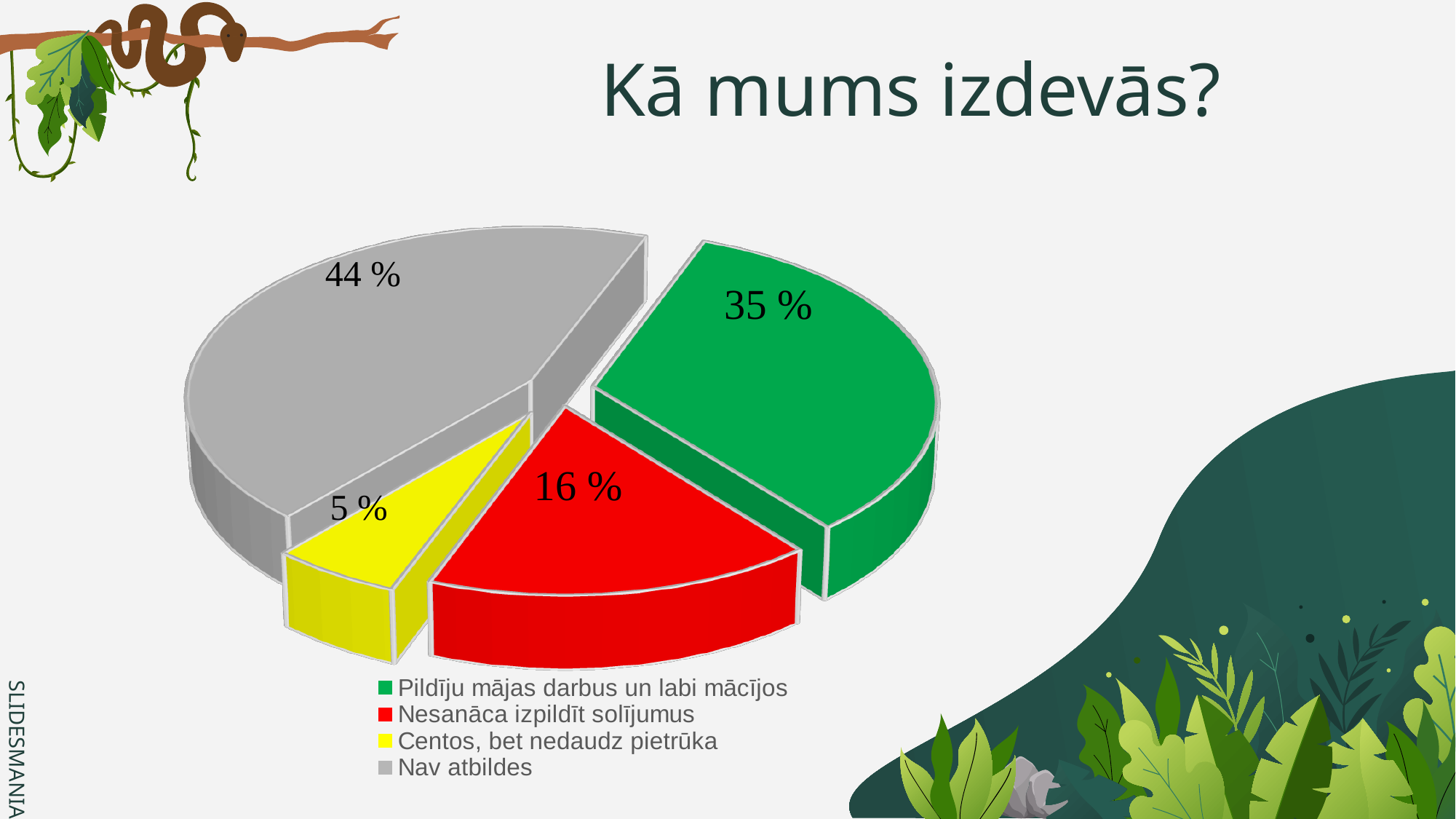
Which is larger: the share for "Nesanāca izpildīt solījumus" or the share for "Centos, bet nedaudz pietrūka"? Nesanāca izpildīt solījumus What share of the pie does "Pildīju mājas darbus un labi mācījos" have? 35 % What kind of chart is shown on the slide? Pie chart How many categories does the pie chart have? 4 What share of the pie does "Centos, bet nedaudz pietrūka" have? 5 % What share of the pie does "Nav atbildes" have? 44 % Which category has the smallest slice of the pie? Centos, bet nedaudz pietrūka What is the title of the slide containing the pie chart? Kā mums izdevās? What colour is the slice for "Nesanāca izpildīt solījumus"? Red What is the difference between the shares of "Nav atbildes" and "Pildīju mājas darbus un labi mācījos"? 9 % Which category has the largest slice of the pie? Nav atbildes